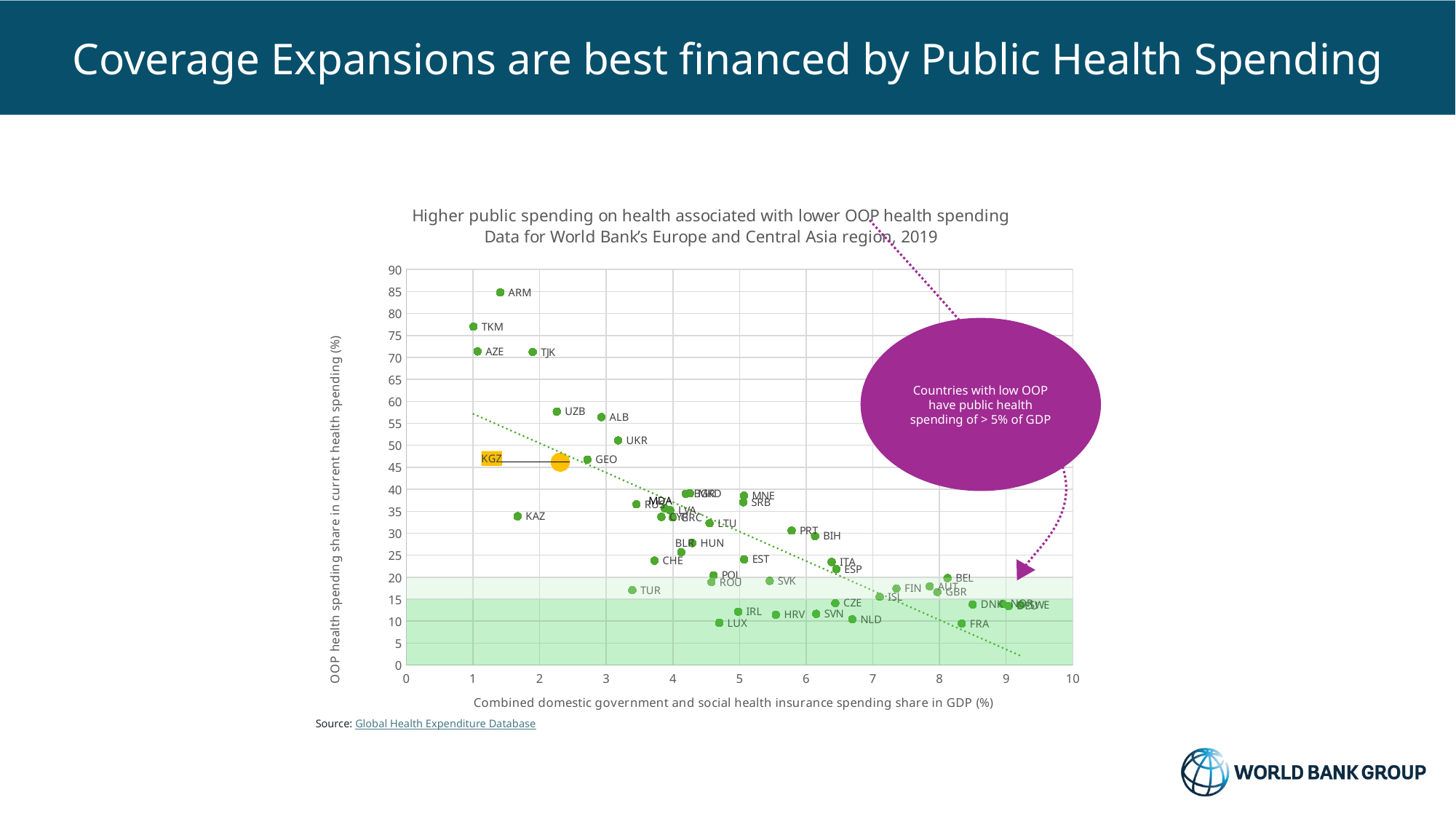
Is the OOP health spending share for ARM greater or less than 80? greater Is the OOP health spending share for KAZ greater or less than 40? less Which country has the highest OOP health spending share in current health spending? ARM Which country is highlighted in orange on the chart? KGZ As combined public health spending share in GDP increases along the x axis, does the OOP health spending share tend to rise or fall? fall What is the label of the x axis of the chart? Combined domestic government and social health insurance spending share in GDP (%) Is the OOP health spending share for FRA greater or less than 15? less Which has a higher OOP health spending share, TUR or IRL? TUR What kind of chart is shown on the slide? Scatter chart Which has a higher OOP health spending share, UZB or KAZ? UZB